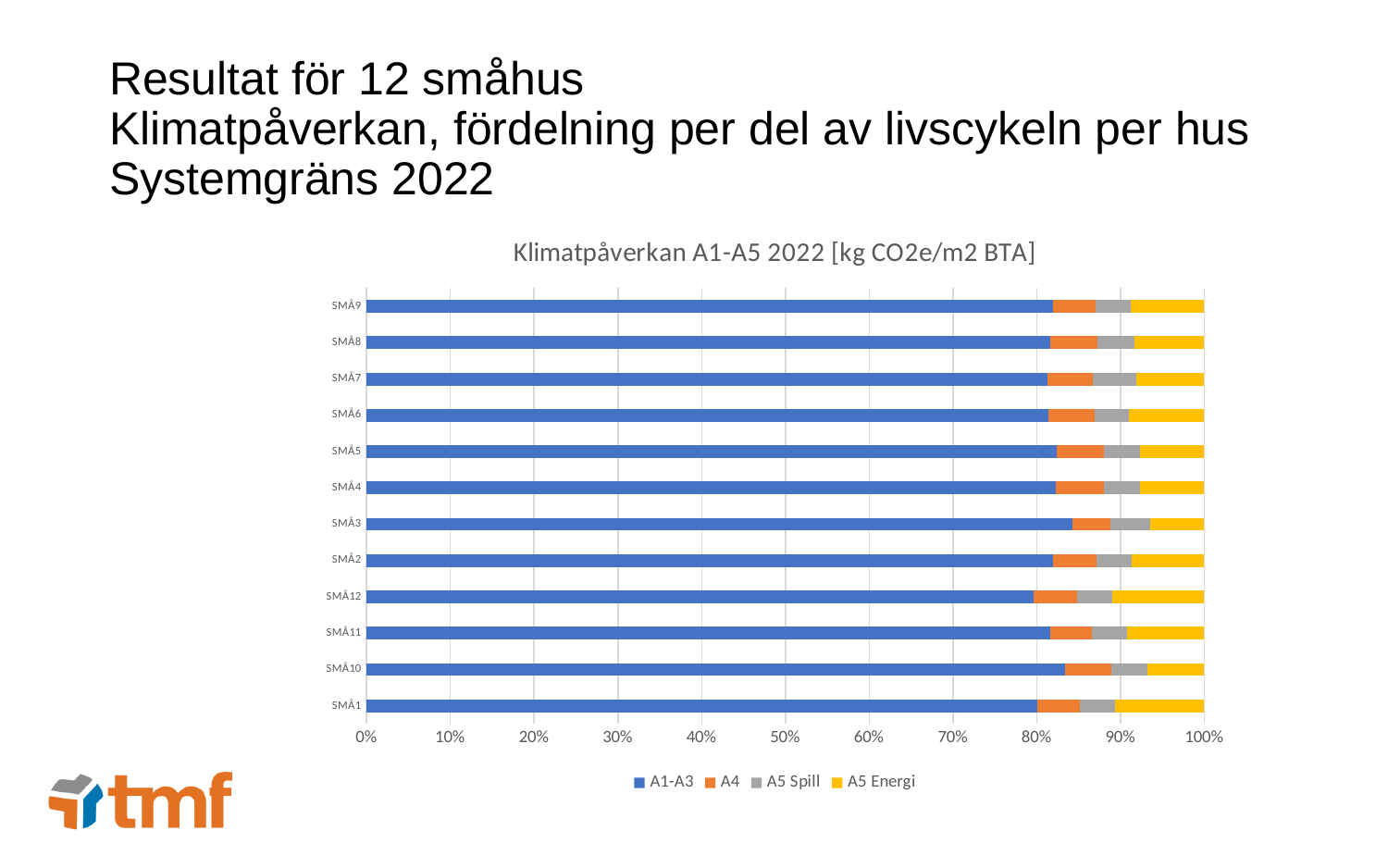
Is the A1-A3 share for SMÅ1 greater or less than 90%? less What does each stacked bar total on the x axis? 100% How many series does the chart legend list? 4 Which has the larger A1-A3 share, SMÅ3 or SMÅ12? SMÅ3 Which house has the largest A5 Energi share of its bar? SMÅ12 Which series is shown in yellow in the chart? A5 Energi What is the title of the chart? Klimatpåverkan A1-A5 2022 [kg CO2e/m2 BTA] How many houses (categories) are plotted in the chart? 12 Which house has the smallest A1-A3 share of its bar? SMÅ12 Is the A1-A3 share for SMÅ3 greater or less than 80%? greater Is the A1-A3 share for SMÅ10 greater or less than 80%? greater What kind of chart is shown on the slide? Stacked bar chart